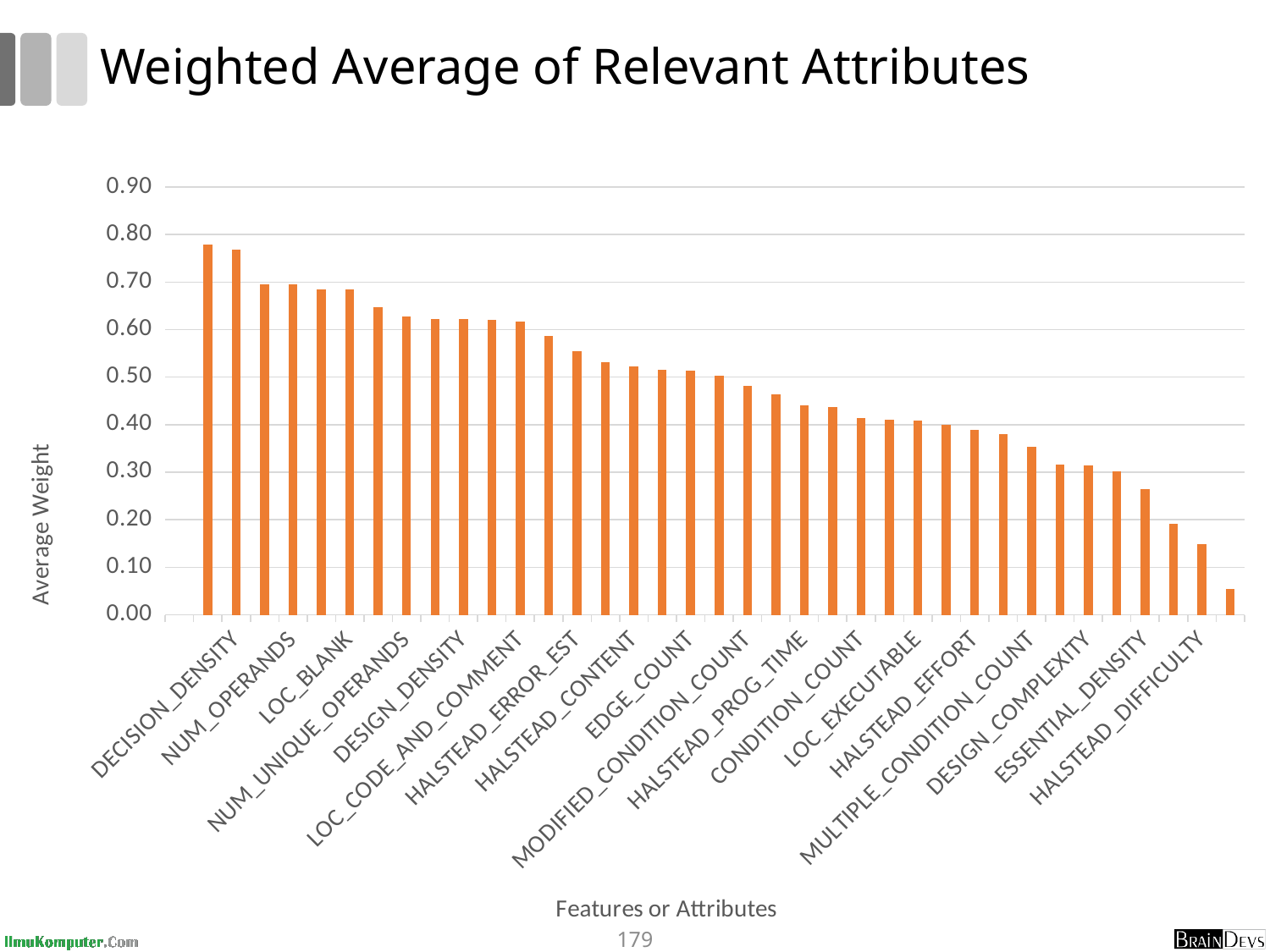
Which labeled attribute has the highest average weight? DECISION_DENSITY Which has a larger average weight, DECISION_DENSITY or HALSTEAD_DIFFICULTY? DECISION_DENSITY Is the value for HALSTEAD_EFFORT greater or less than 0.50? less Is the value for HALSTEAD_DIFFICULTY greater or less than 0.30? less What is the label of the vertical axis? Average Weight What kind of chart is shown on the slide? bar chart Is the value for LOC_BLANK greater or less than 0.60? greater What is the title of the chart? Weighted Average of Relevant Attributes Do the bar values rise or fall from left to right along the x axis? fall Which has a larger average weight, NUM_OPERANDS or CONDITION_COUNT? NUM_OPERANDS How many attribute labels are shown on the x axis? 18